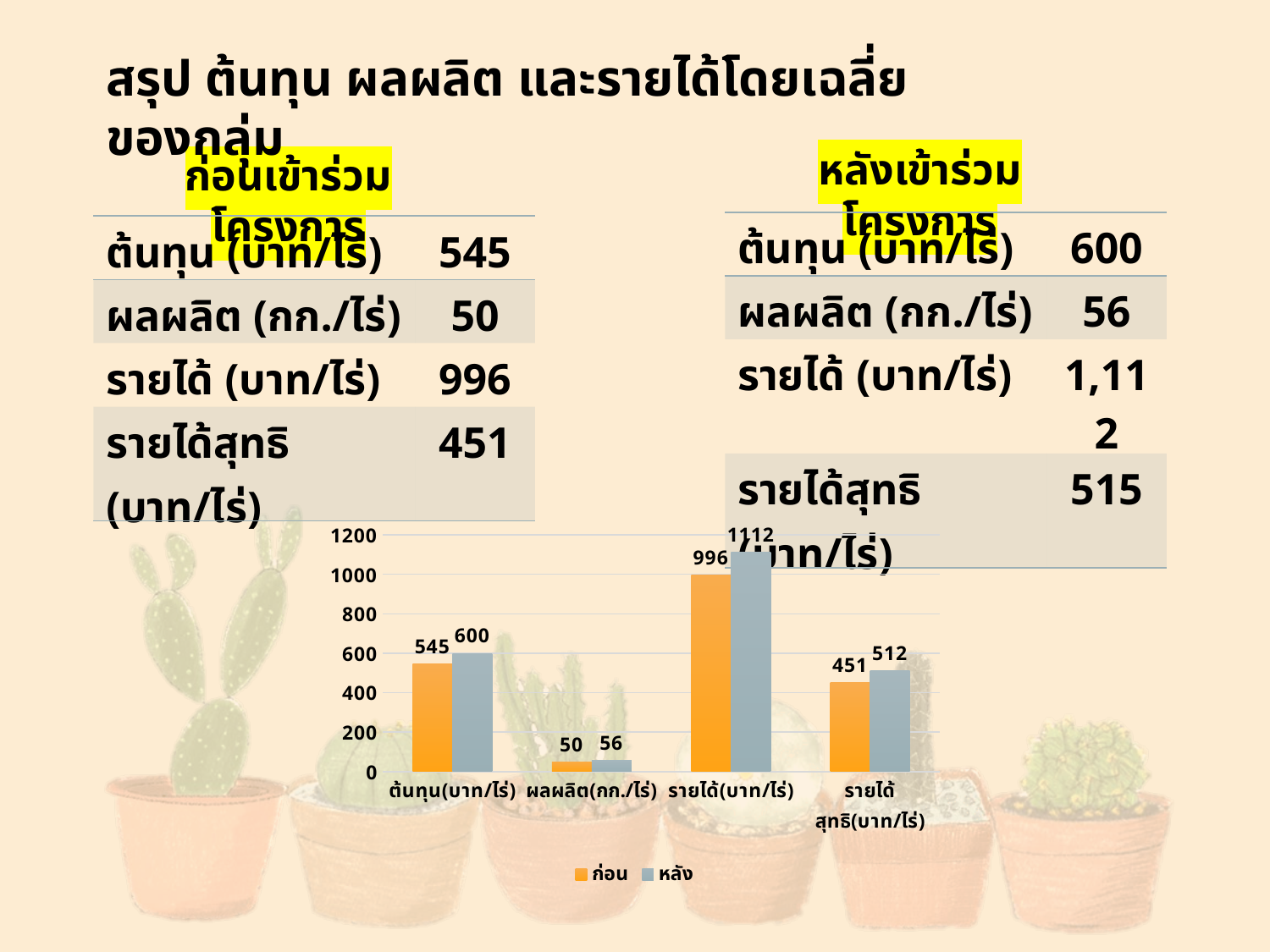
How many series does the chart legend list? 2 What is the value of the ก่อน series for รายได้สุทธิ(บาท/ไร่) in the chart? 451 Which category has the lowest value for the ก่อน series in the chart? ผลผลิต(กก./ไร่) What is the value of the หลัง series for ต้นทุน(บาท/ไร่) in the chart? 600 What colour are the bars for the ก่อน series in the chart? orange For ผลผลิต(กก./ไร่), which series has the larger value in the chart, ก่อน or หลัง? หลัง What is the difference between the หลัง and ก่อน values for รายได้(บาท/ไร่) in the chart? 116 What type of chart is shown on the slide? bar chart Which category has the highest value for the หลัง series in the chart? รายได้(บาท/ไร่) What is the value of the ก่อน series for ต้นทุน(บาท/ไร่) in the chart? 545 How many categories are shown on the x axis of the chart? 4 What is the value of the หลัง series for รายได้(บาท/ไร่) in the chart? 1112